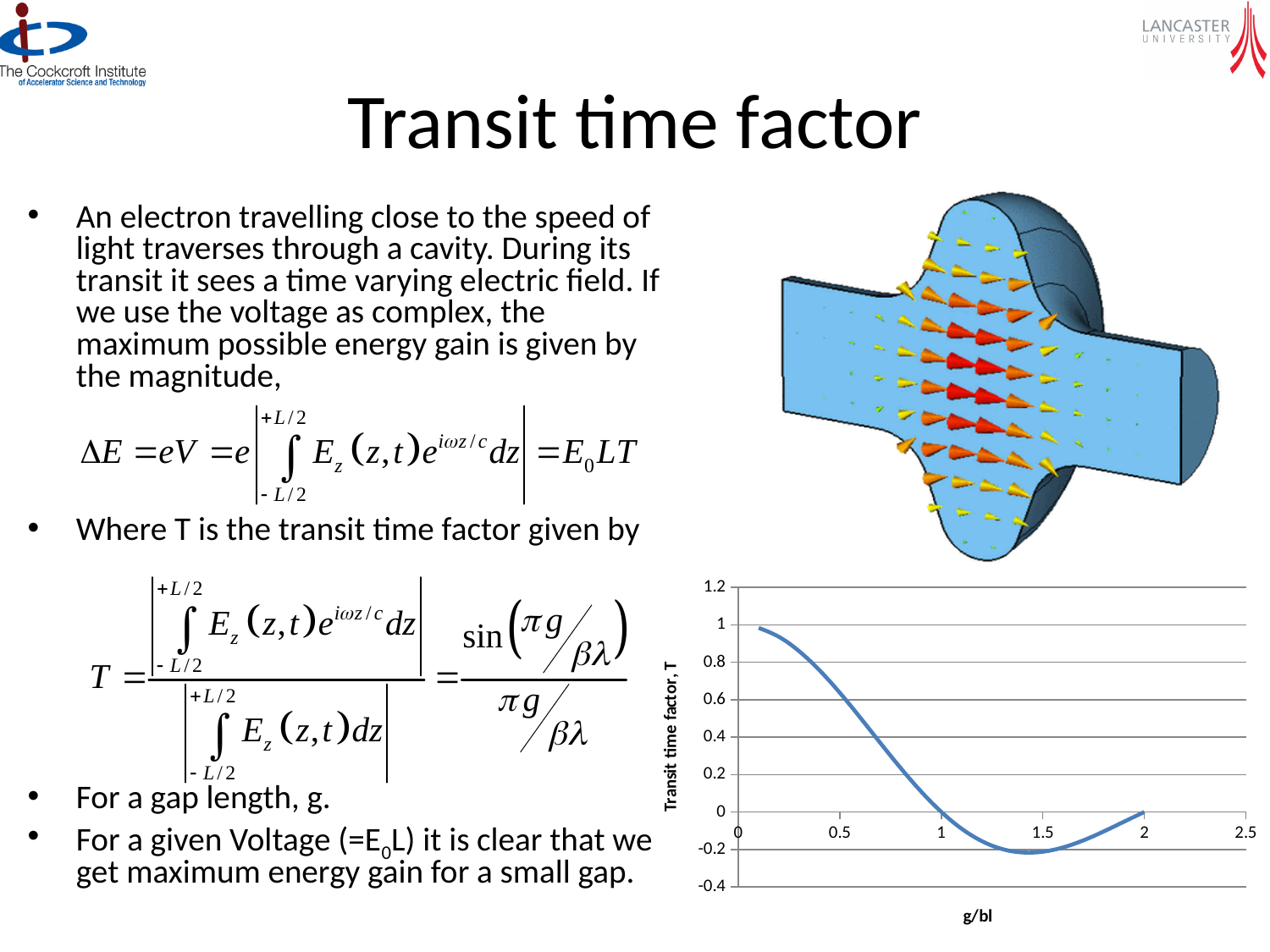
What is the highest value shown on the vertical axis of the chart? 1.2 What is the value of the transit time factor at g/bl = 2? 0 Is the transit time factor at g/bl = 0.5 greater or less than 1? less What is the value of the transit time factor at g/bl = 1? 0 Is the transit time factor at g/bl = 1.5 greater or less than 0? less What is the label of the horizontal axis of the chart? g/bl What kind of chart is shown at the bottom right of the slide? line chart Is the transit time factor at g/bl = 0.5 greater or less than 0.4? greater Which is larger, the transit time factor at g/bl = 0.5 or at g/bl = 1.5? g/bl = 0.5 What is the label of the vertical axis of the chart? Transit time factor, T Does the transit time factor rise or fall as g/bl increases from 1.5 to 2? rise Does the transit time factor rise or fall as g/bl increases from 0 to 1? fall